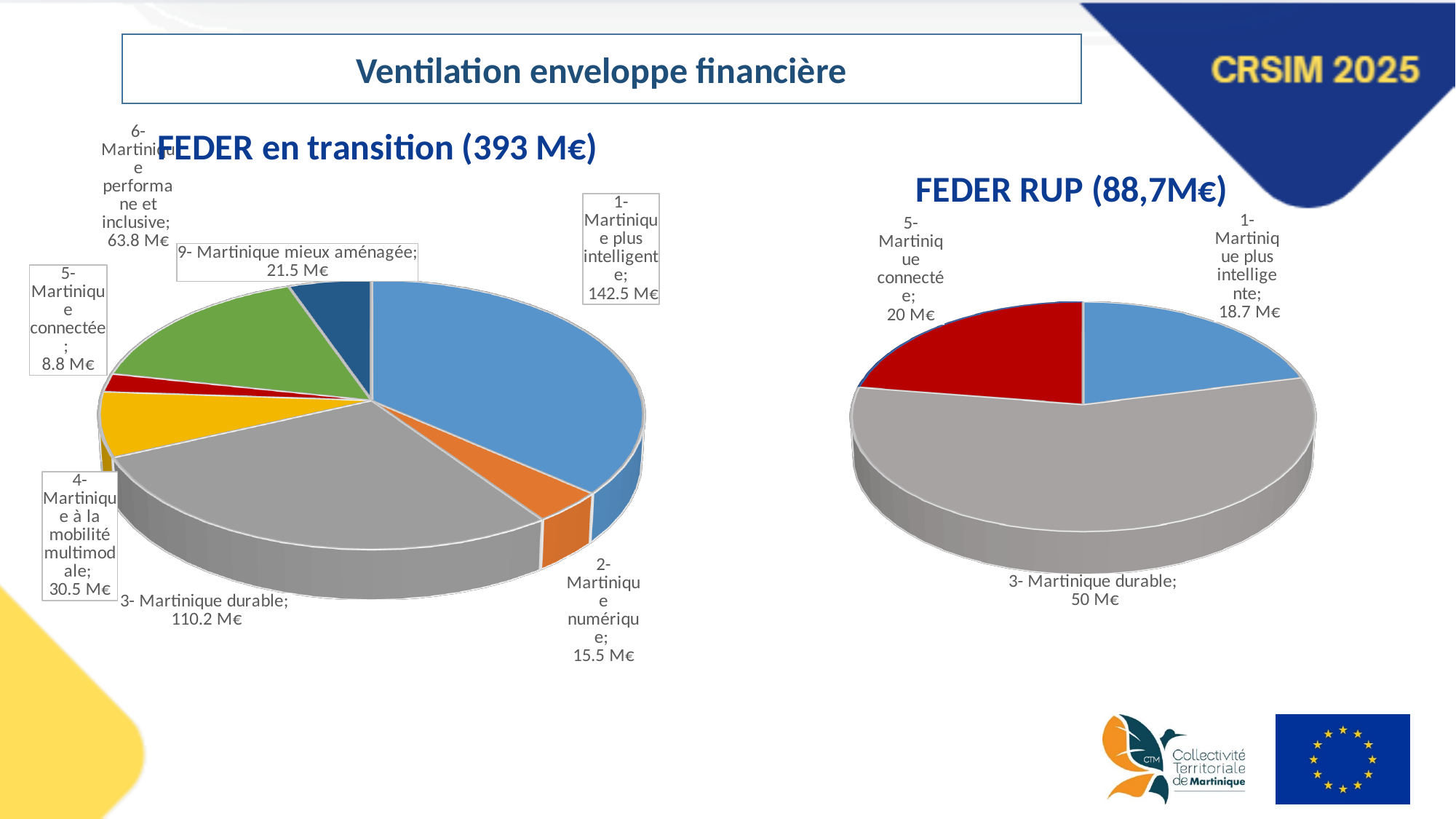
In the FEDER en transition chart, which category has the largest slice? 1- Martinique plus intelligente In the FEDER en transition chart, what is the difference between 1- Martinique plus intelligente and 3- Martinique durable? 32.3 M€ How many categories are shown in the FEDER en transition chart? 7 How many categories are shown in the FEDER RUP chart? 3 In the FEDER RUP chart, what is the difference between 3- Martinique durable and 5- Martinique connectée? 30 M€ In the FEDER en transition chart, what is the value for 1- Martinique plus intelligente? 142.5 M€ In the FEDER en transition chart, what is the value for 5- Martinique connectée? 8.8 M€ In the FEDER en transition chart, which category has the smallest slice? 5- Martinique connectée In the FEDER en transition chart, what is the value for 3- Martinique durable? 110.2 M€ In the FEDER RUP chart, what is the value for 1- Martinique plus intelligente? 18.7 M€ What type of chart is the FEDER RUP chart? Pie chart In the FEDER RUP chart, what is the value for 3- Martinique durable? 50 M€